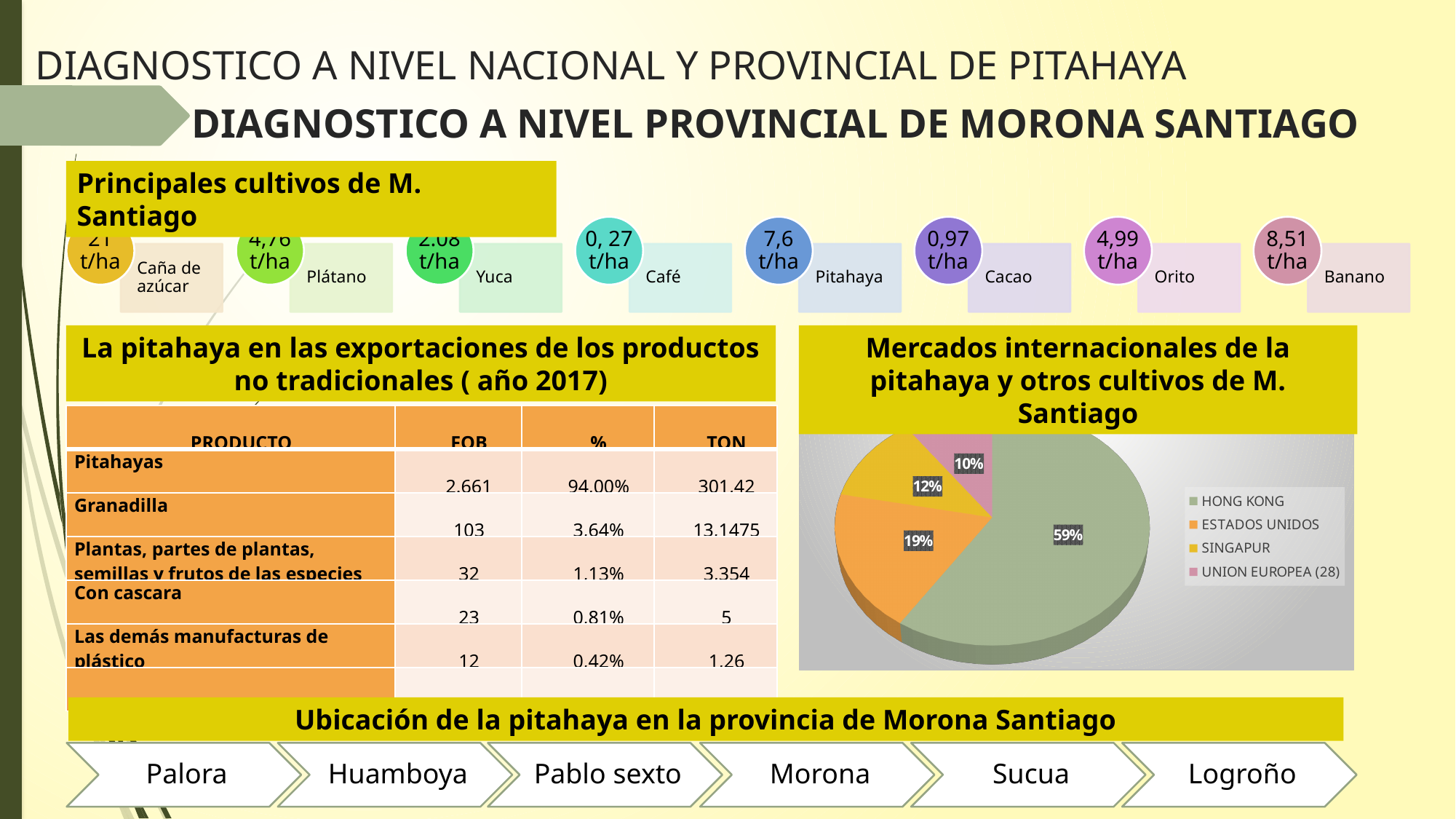
What kind of chart is shown under the title 'Mercados internacionales de la pitahaya y otros cultivos de M. Santiago'? pie chart Which market has the largest slice in the pie chart? HONG KONG In the pie chart, what is the combined share of SINGAPUR and UNION EUROPEA (28)? 22% In the pie chart, what share does HONG KONG have? 59% In the pie chart, what share does SINGAPUR have? 12% In the pie chart, what is the difference between the shares of HONG KONG and ESTADOS UNIDOS? 40% Which market has the smallest slice in the pie chart? UNION EUROPEA (28) What colour is the HONG KONG slice in the pie chart? green In the pie chart, what share does ESTADOS UNIDOS have? 19% How many markets are listed in the legend of the pie chart? 4 In the pie chart, what share does UNION EUROPEA (28) have? 10% In the pie chart, which is larger: the share of SINGAPUR or the share of UNION EUROPEA (28)? SINGAPUR